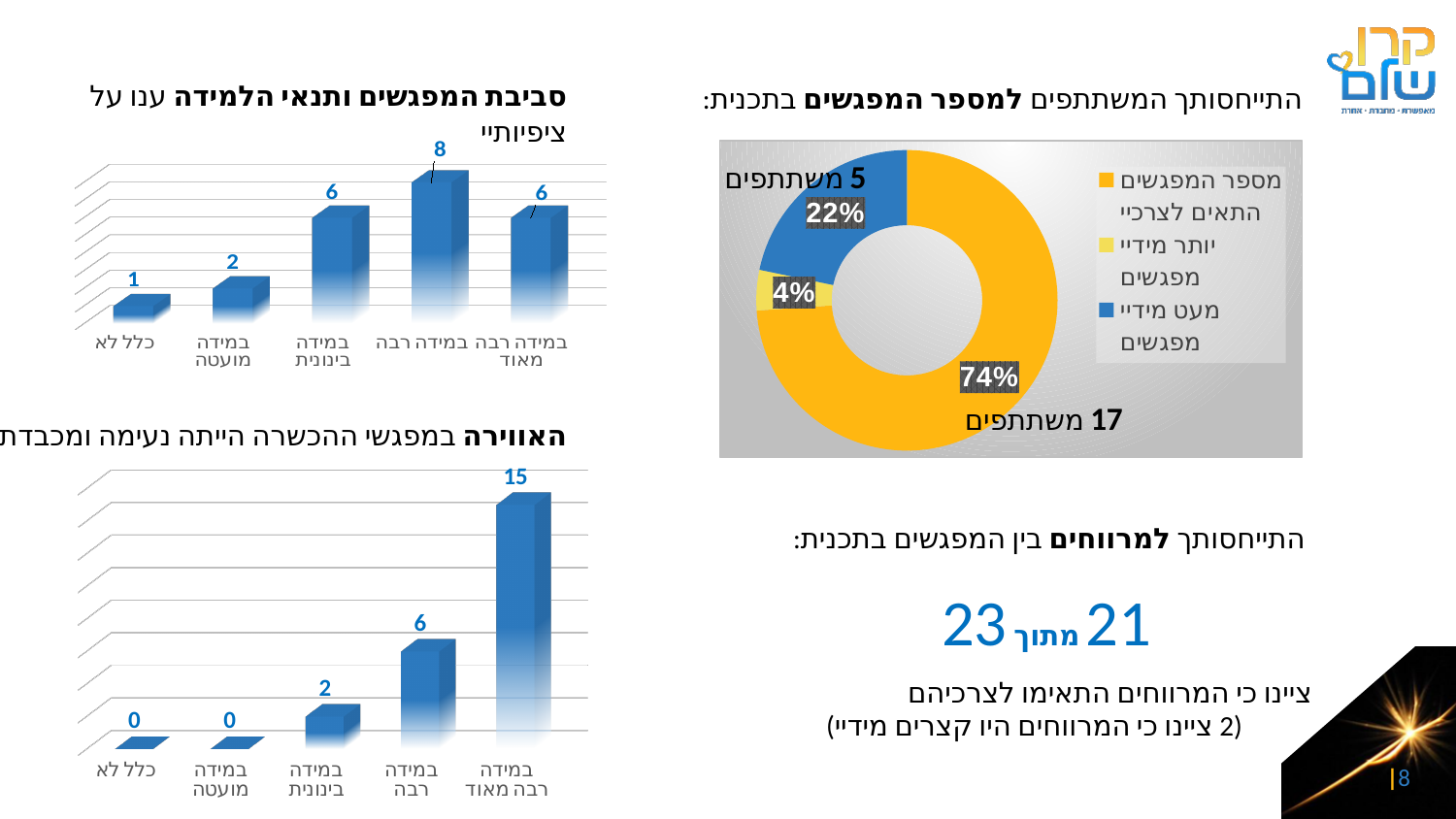
In the donut chart at the top right, what percentage is shown for the slice labelled 5 משתתפים? 22% What kind of chart is the chart at the top right of the slide? Donut (pie) chart How many categories are shown on the x axis of the top-left bar chart (סביבת המפגשים ותנאי הלמידה)? 5 In the bottom-left bar chart (האווירה במפגשי ההכשרה), how many categories have a value of 0? 2 In the bottom-left bar chart (האווירה במפגשי ההכשרה), which is larger, the value for במידה רבה or the value for במידה בינונית? במידה רבה In the bottom-left bar chart (האווירה במפגשי ההכשרה), what is the value for במידה רבה מאוד? 15 In the top-left bar chart (סביבת המפגשים ותנאי הלמידה), what is the difference between the values for במידה רבה and במידה מועטה? 6 How many entries does the legend of the donut chart at the top right list? 3 In the donut chart at the top right, what percentage is shown for the largest slice (17 משתתפים)? 74% In the top-left bar chart (סביבת המפגשים ותנאי הלמידה), which category has the lowest value? כלל לא In the top-left bar chart (סביבת המפגשים ותנאי הלמידה), what is the value for במידה רבה? 8 In the donut chart at the top right, what is the smallest percentage shown? 4%